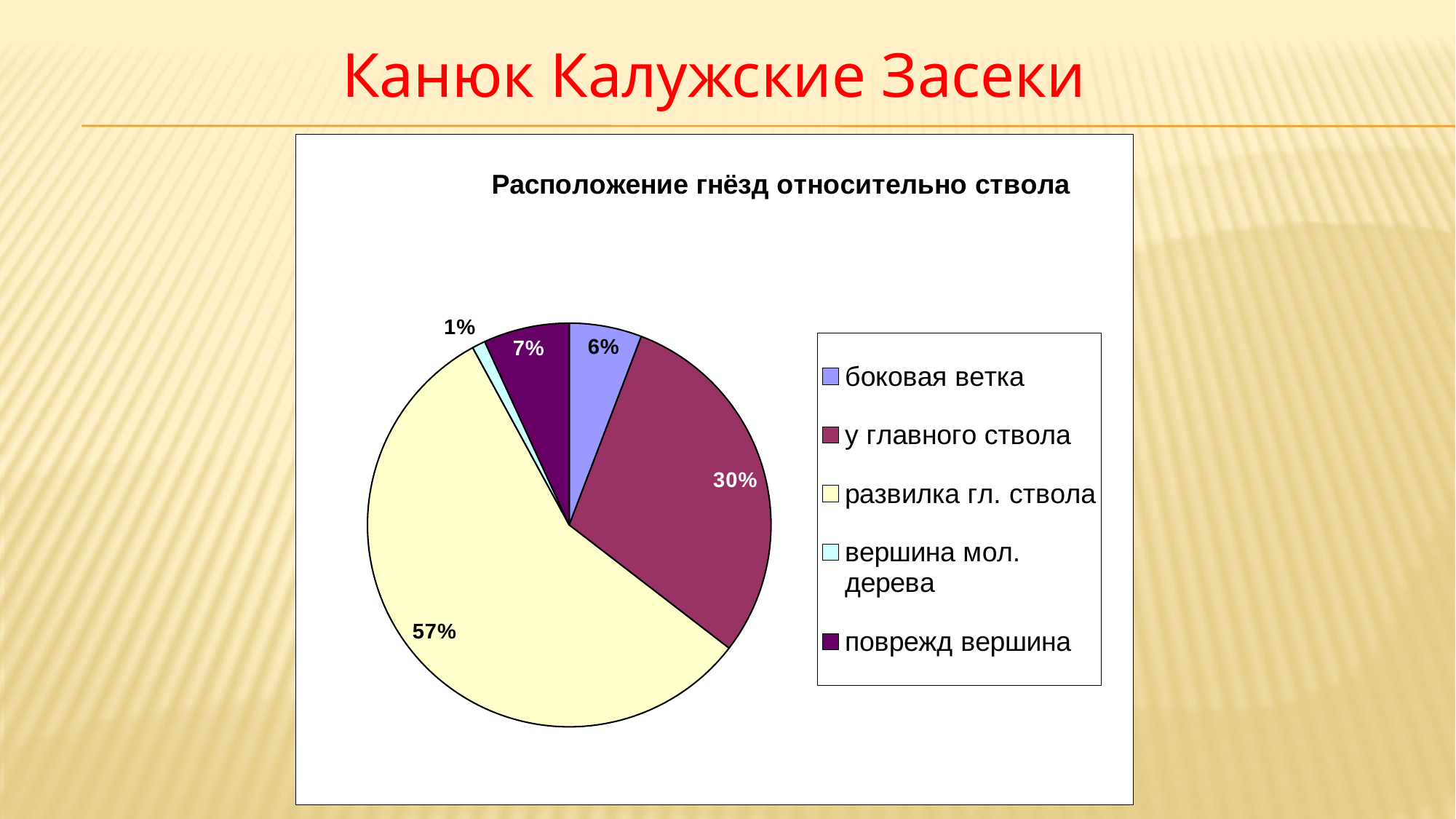
What share of the pie does 'у главного ствола' take? 30% What is the difference between the shares of 'развилка гл. ствола' and 'у главного ствола'? 27% Which category has the largest slice? развилка гл. ствола What share of the pie does 'развилка гл. ствола' take? 57% What is the value for 'поврежд вершина'? 7% How many categories does the legend list? 5 What is the title of the chart? Расположение гнёзд относительно ствола What is the value for 'вершина мол. дерева'? 1% What is the value for 'боковая ветка'? 6% What kind of chart is shown on the slide? pie chart Which category has the smallest slice? вершина мол. дерева Which is larger, the slice for 'поврежд вершина' or the slice for 'боковая ветка'? поврежд вершина